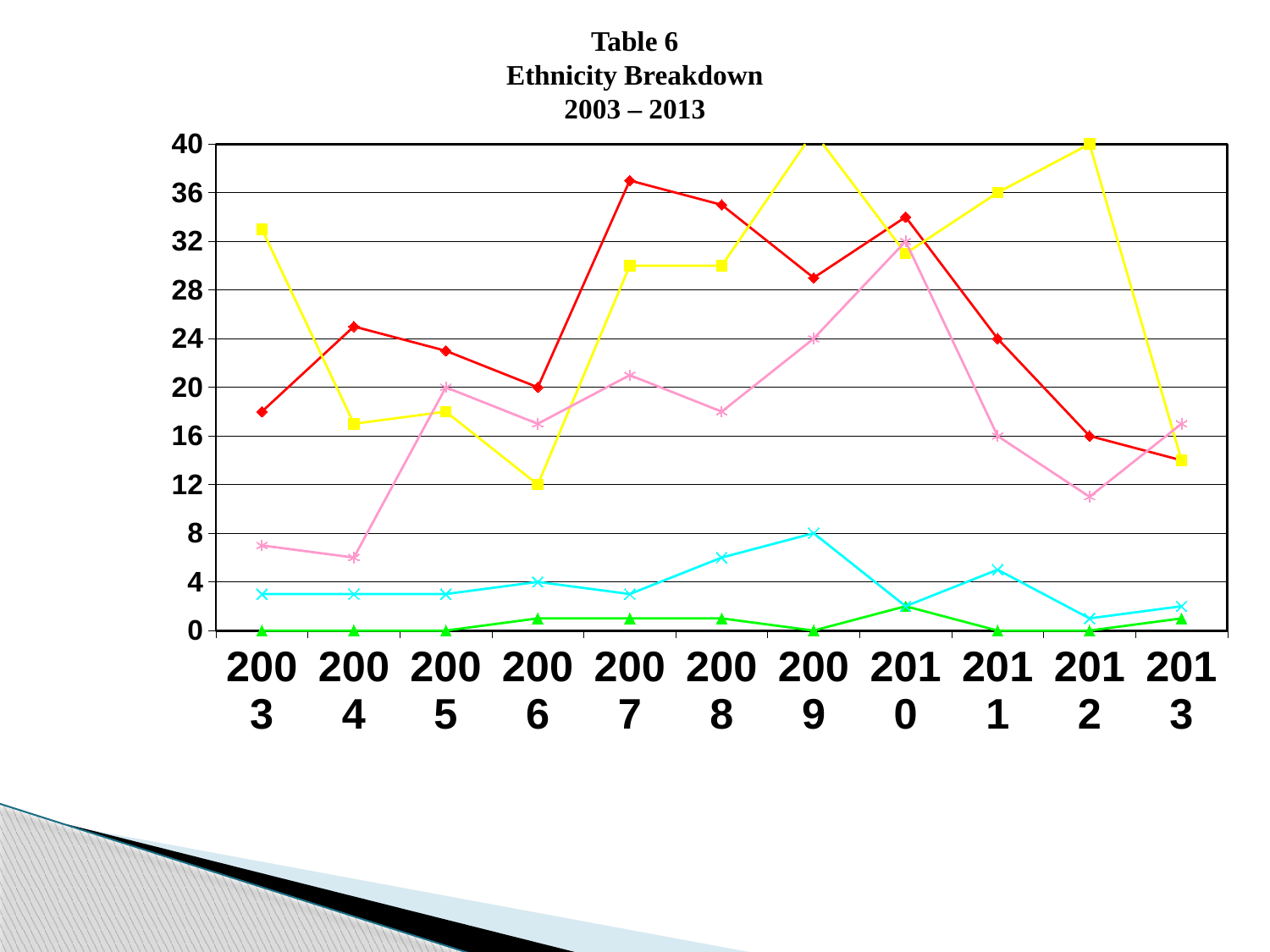
What is the value of the red line in 2006? 20 What kind of chart is shown on the slide? line chart What is the title of the chart? Table 6 Ethnicity Breakdown 2003 – 2013 In 2003, which is larger, the yellow line or the red line? yellow line Is the value of the red line in 2007 greater or less than 36? greater In which year is the yellow line at its lowest? 2006 What is the value of the cyan line in 2009? 8 How many lines are plotted on the chart? 5 In which year is the cyan line at its highest? 2009 How many years are shown along the x axis? 11